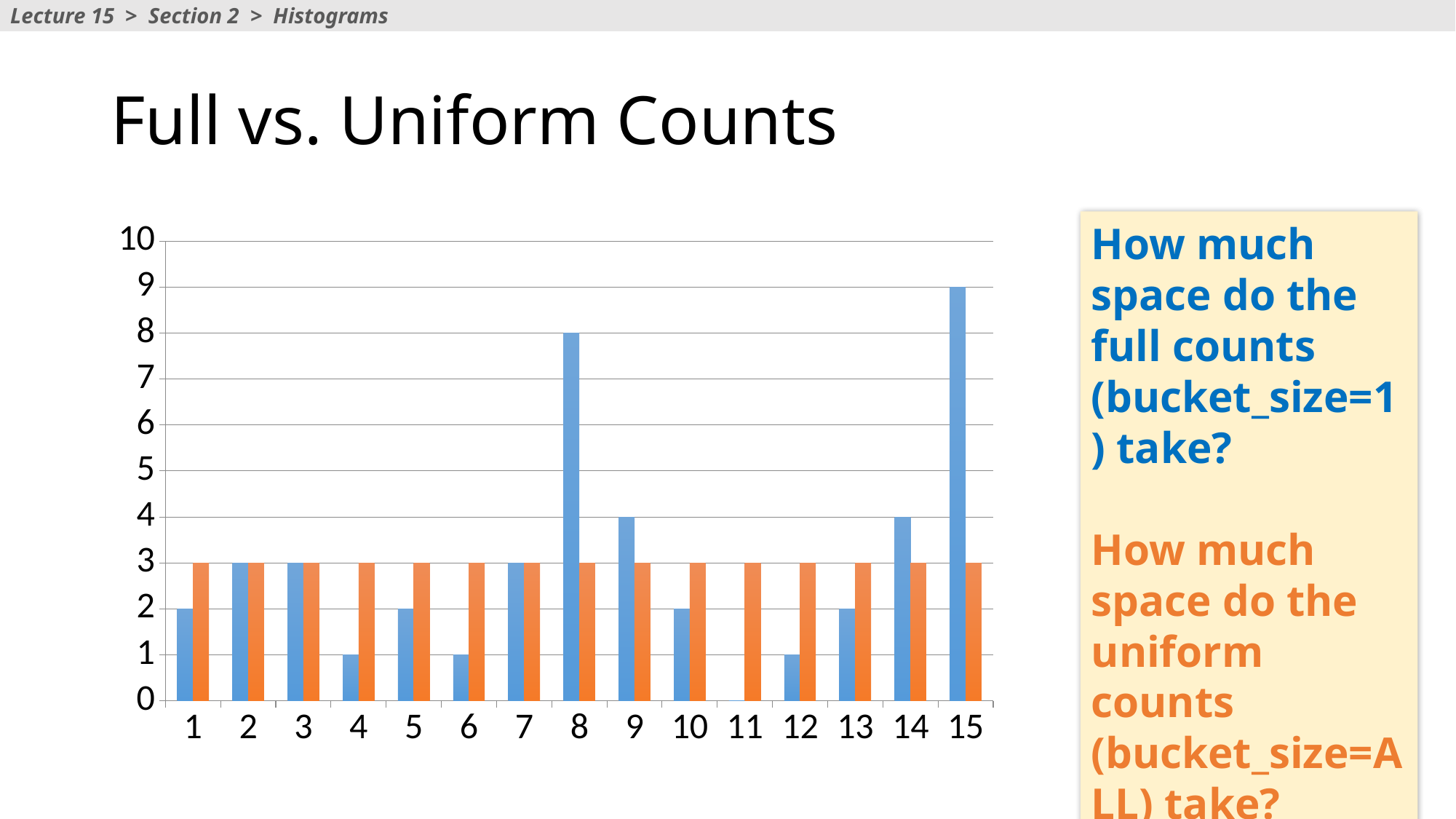
What is the title of the slide containing the chart? Full vs. Uniform Counts What is the value of the blue bar for category 8? 8 How many categories are shown along the x axis of the chart? 15 What is the value of the blue bar for category 15? 9 Is the value of the blue bar for category 8 greater or less than 5? greater What is the value of the orange bar for category 5? 3 Which is larger, the blue bar for category 9 or the blue bar for category 13? category 9 What is the value of the blue bar for category 4? 1 What is the difference between the blue bar for category 15 and the blue bar for category 8? 1 What kind of chart is shown on the slide? bar chart Which category has the lowest blue bar? 11 Which category has the highest blue bar? 15